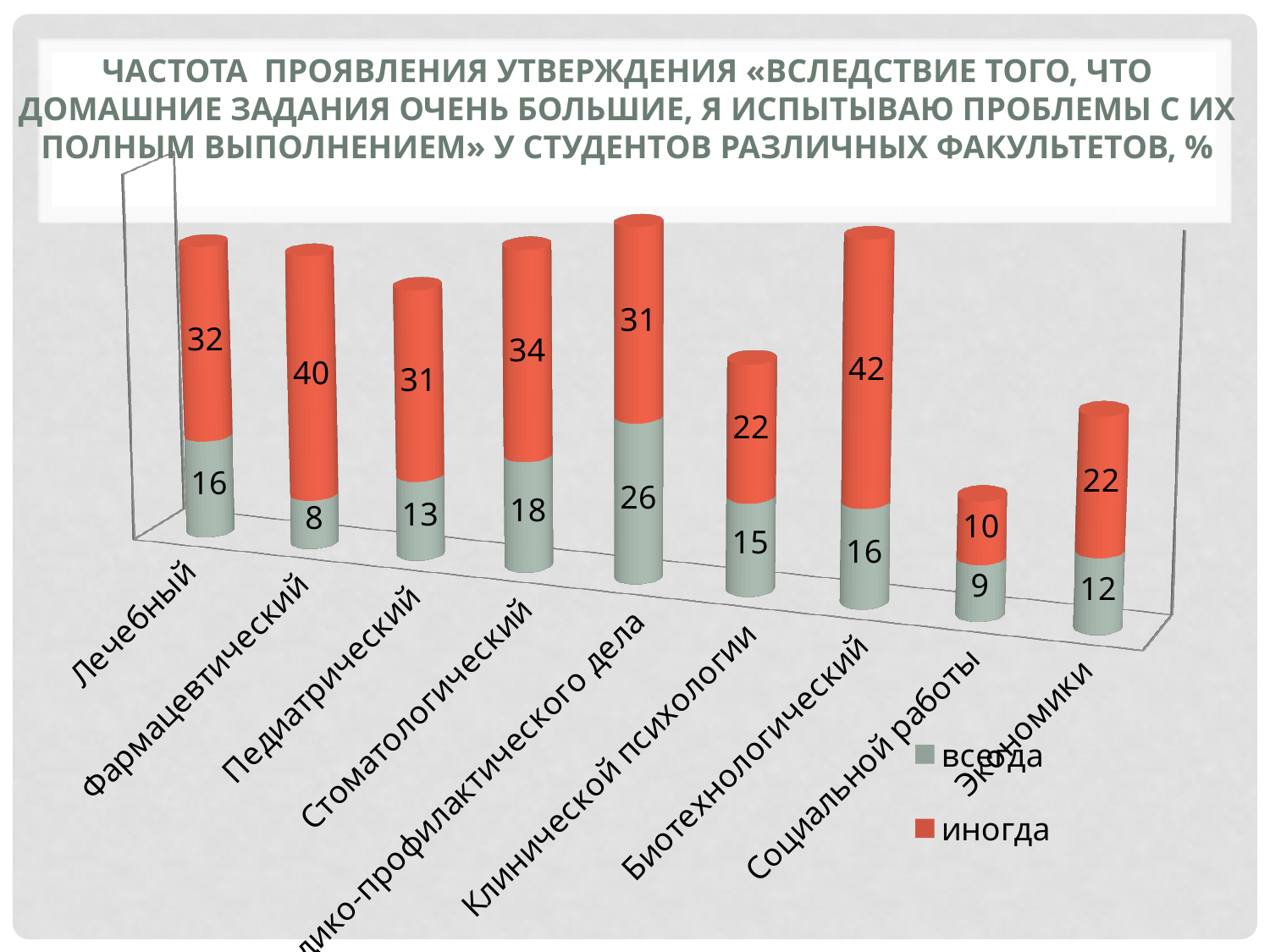
What is the total of the stacked bar for Педиатрический? 44 How many series does the legend list? 2 What is the value of the "всегда" series for Стоматологический? 18 Which faculty has the lowest value for the "всегда" series? Фармацевтический What is the value of the "иногда" series for Фармацевтический? 40 Which faculty has the highest value for the "иногда" series? Биотехнологический For Биотехнологический, what is the difference between the "иногда" value and the "всегда" value? 26 What kind of chart is shown on the slide? Stacked bar chart Which colour represents the "иногда" series in the legend? Red How many faculties (categories) are shown on the chart? 9 What is the value of the "всегда" series for Лечебный? 16 Which has the larger "всегда" value: Лечебный or Клинической психологии? Лечебный